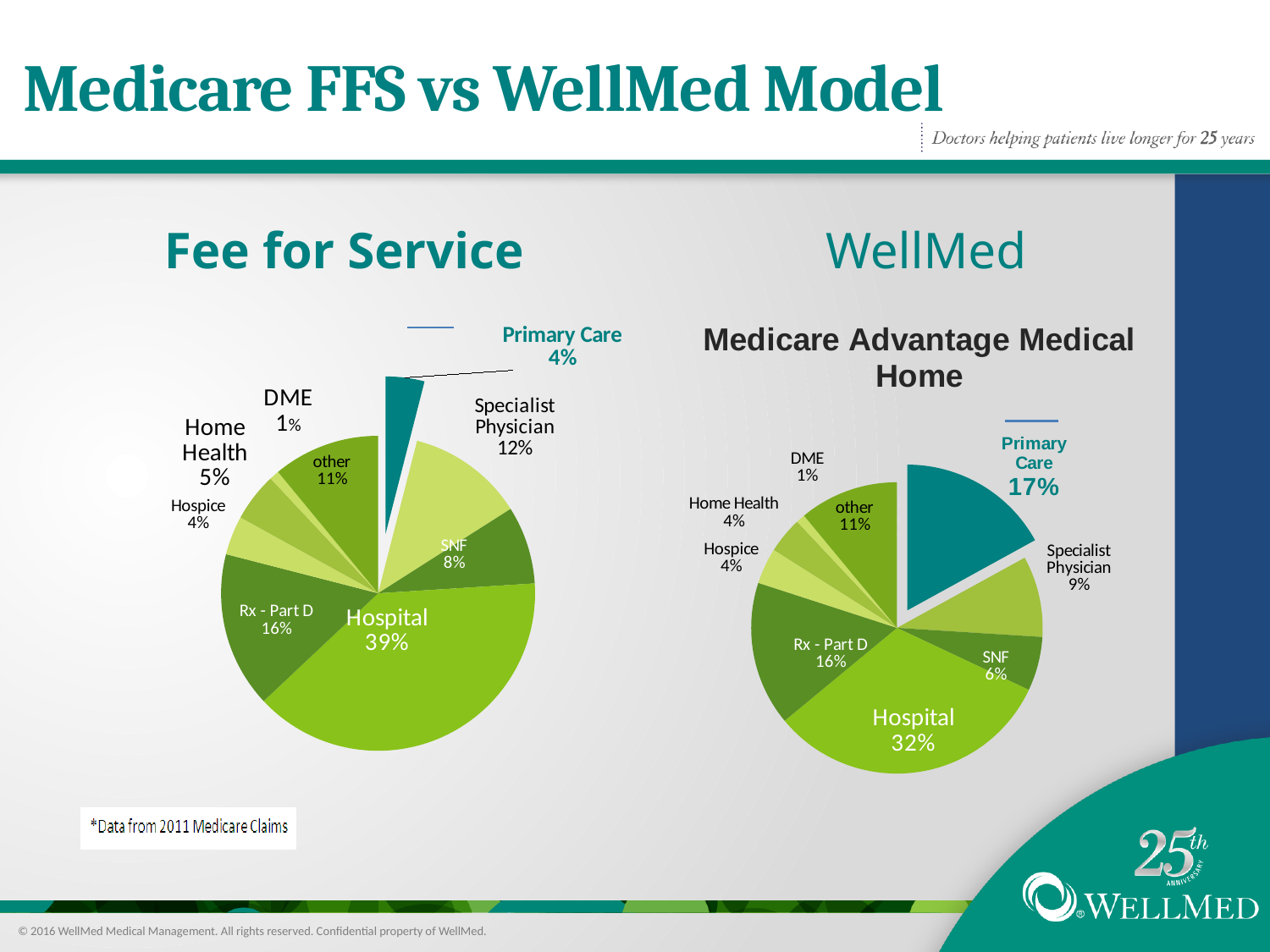
In the Fee for Service pie chart, which category has the largest share? Hospital What is the difference between the Primary Care share in the Medicare Advantage Medical Home chart and the Primary Care share in the Fee for Service chart? 13% In the Fee for Service pie chart, what share does Hospital have? 39% In the Medicare Advantage Medical Home pie chart, which category has the smallest share? DME Which chart shows a larger Specialist Physician share, Fee for Service or Medicare Advantage Medical Home? Fee for Service How many slices does the Fee for Service pie chart have? 9 In the Medicare Advantage Medical Home pie chart, what share does SNF have? 6% What type of chart is used for the Medicare Advantage Medical Home data? Pie chart In the Fee for Service pie chart, what share does Primary Care have? 4% In the Fee for Service pie chart, what is the difference between the Hospital share and the Rx - Part D share? 23% In the Medicare Advantage Medical Home pie chart, what share does Hospital have? 32% In the Medicare Advantage Medical Home pie chart, what share does Primary Care have? 17%